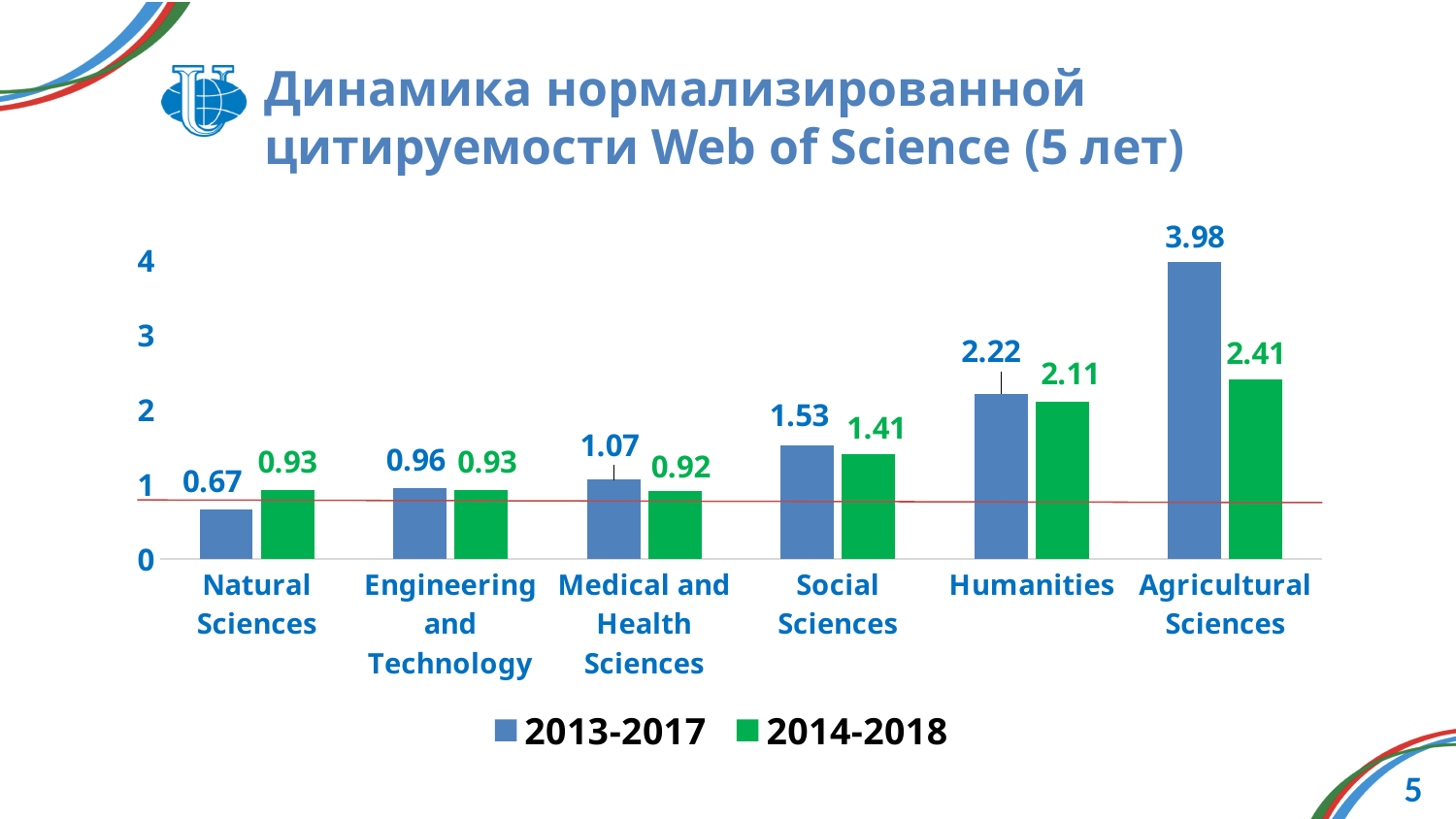
Which category has the highest value in the 2013-2017 series? Agricultural Sciences What is the value for Medical and Health Sciences in the 2013-2017 series? 1.07 Which colour represents the 2014-2018 series? green How many categories are shown on the x axis? 6 Which is larger for Natural Sciences: the 2013-2017 value or the 2014-2018 value? 2014-2018 What kind of chart is shown on the slide? bar chart What is the value for Agricultural Sciences in the 2014-2018 series? 2.41 Which category has the lowest value in the 2014-2018 series? Medical and Health Sciences How many series does the legend list? 2 Is the 2013-2017 value for Humanities greater or less than 2? greater What is the difference between the 2013-2017 and 2014-2018 values for Agricultural Sciences? 1.57 What is the value for Natural Sciences in the 2013-2017 series? 0.67